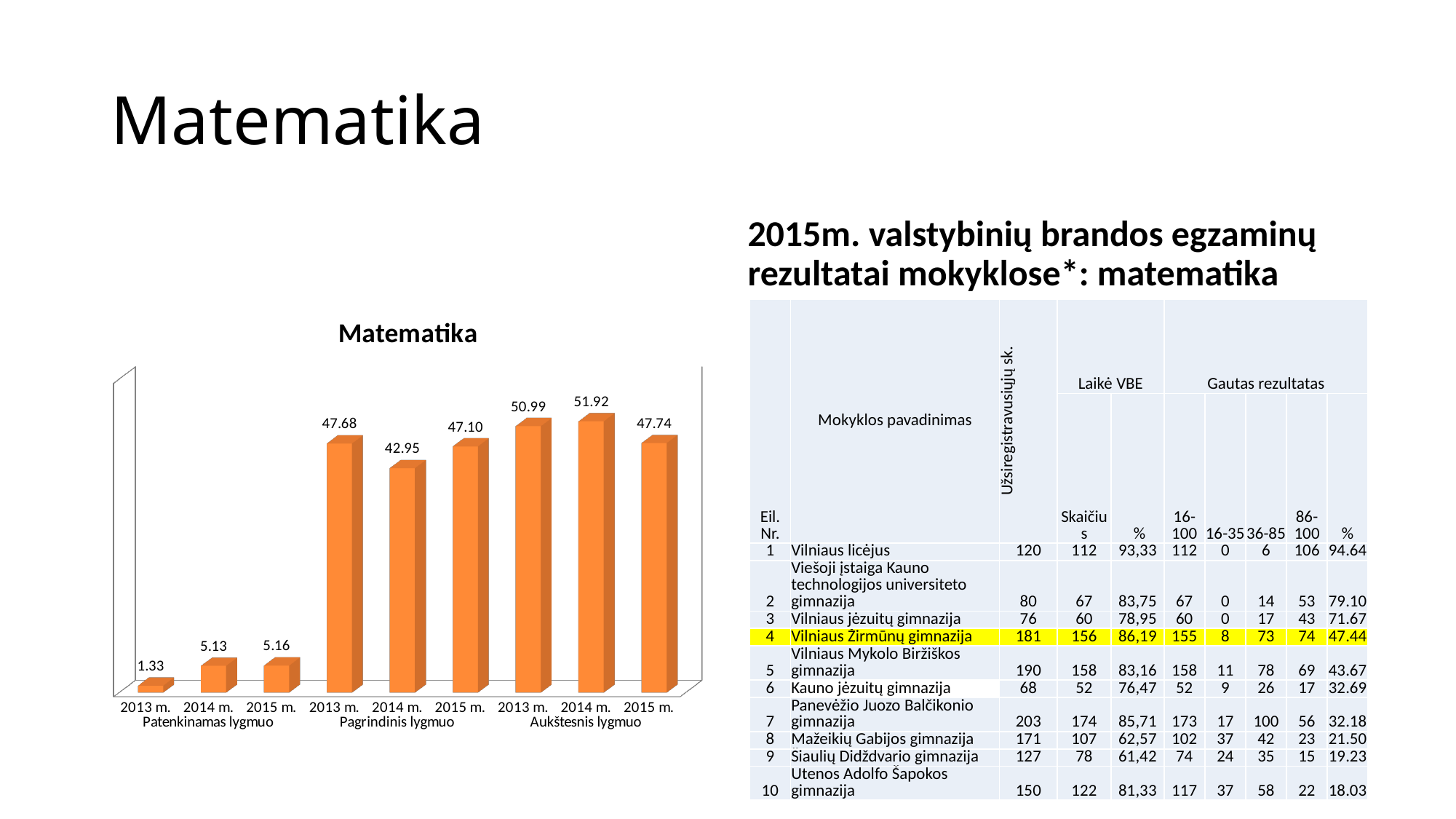
What is the difference between the 2014 m. and 2013 m. values in the Aukštesnis lygmuo group of the Matematika chart? 0.93 How many bars are plotted in the Matematika chart? 9 Which bar has the highest value in the Matematika chart? 2014 m. Aukštesnis lygmuo What is the value for 2014 m. in the Pagrindinis lygmuo group of the Matematika chart? 42.95 What is the value for 2013 m. in the Patenkinamas lygmuo group of the Matematika chart? 1.33 What type of chart is the Matematika chart? bar chart How many level groups are shown on the x axis of the Matematika chart? 3 Which bar has the lowest value in the Matematika chart? 2013 m. Patenkinamas lygmuo What is the difference between the 2013 m. and 2014 m. values in the Pagrindinis lygmuo group of the Matematika chart? 4.73 In the Matematika chart, which is larger: the 2015 m. value for Pagrindinis lygmuo or the 2015 m. value for Aukštesnis lygmuo? 2015 m. Aukštesnis lygmuo What is the value for 2015 m. in the Aukštesnis lygmuo group of the Matematika chart? 47.74 In the Matematika chart, do the values in the Patenkinamas lygmuo group rise or fall from 2013 m. to 2015 m.? rise